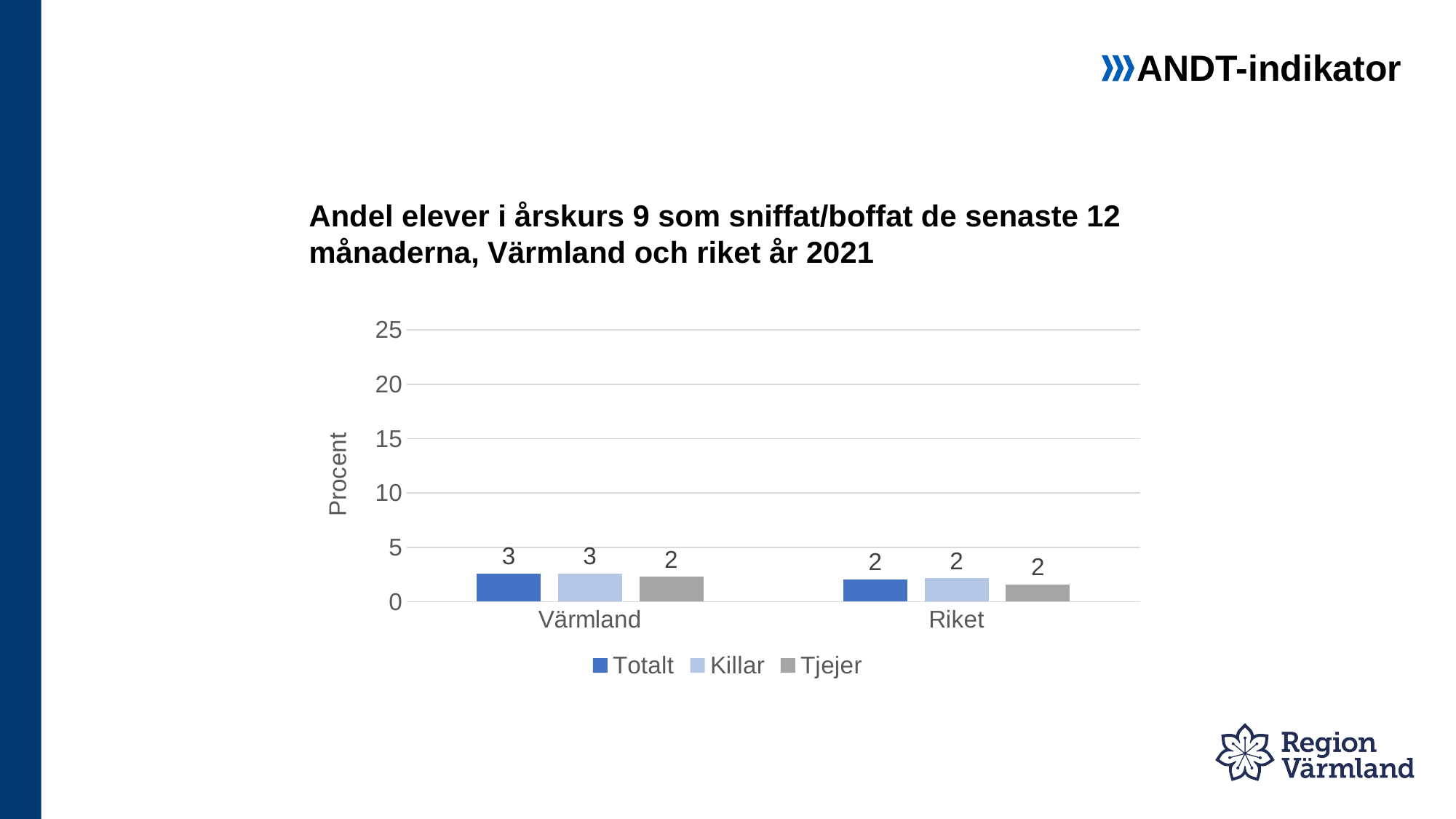
What is the difference between the Killar value for Värmland and the Killar value for Riket? 1 What is the value for Totalt in Riket? 2 Which is larger, the Totalt value for Värmland or the Totalt value for Riket? Värmland What is the value for Tjejer in Värmland? 2 Is the value for Totalt in Värmland greater or less than 5? less How many categories are shown on the x axis? 2 What is the value for Killar in Riket? 2 What kind of chart is shown on the slide? bar chart What is the label of the y axis? Procent What is the value for Totalt in Värmland? 3 How many series does the legend list? 3 What is the value for Killar in Värmland? 3